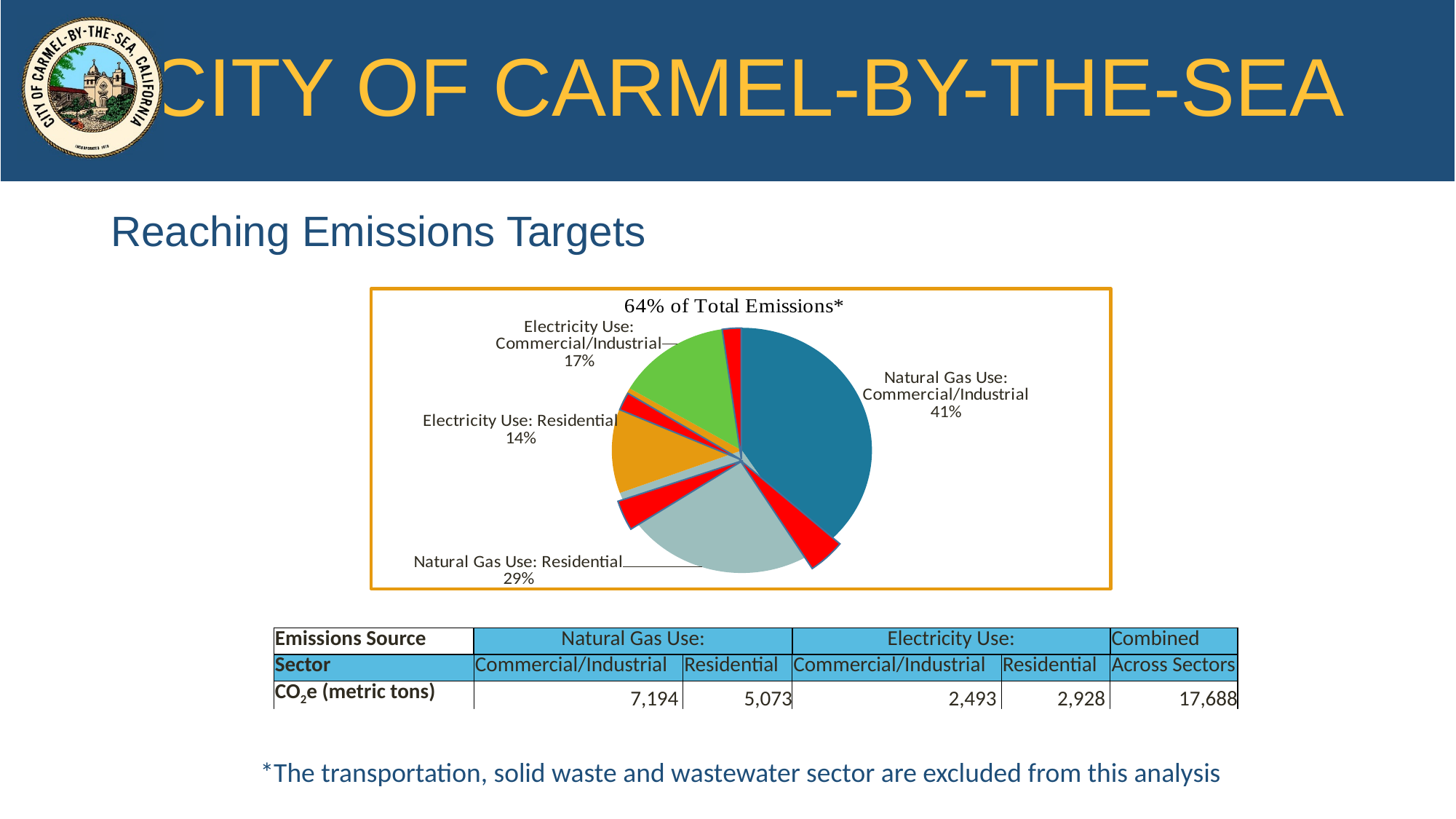
What is the combined share of the two Natural Gas Use slices in the pie chart? 70% By how many percentage points does Natural Gas Use: Commercial/Industrial exceed Natural Gas Use: Residential in the pie chart? 12 percentage points Which is larger in the pie chart: Electricity Use: Commercial/Industrial or Electricity Use: Residential? Electricity Use: Commercial/Industrial Which is larger in the pie chart: Natural Gas Use: Residential or Electricity Use: Commercial/Industrial? Natural Gas Use: Residential What is the title of the pie chart? 64% of Total Emissions* What share of the pie does Natural Gas Use: Residential represent? 29% What type of chart is shown on the slide? Pie chart Which labeled slice of the pie chart is the largest? Natural Gas Use: Commercial/Industrial What share of the pie does Electricity Use: Residential represent? 14% Which labeled slice of the pie chart is the smallest? Electricity Use: Residential What share of the pie does Natural Gas Use: Commercial/Industrial represent? 41%